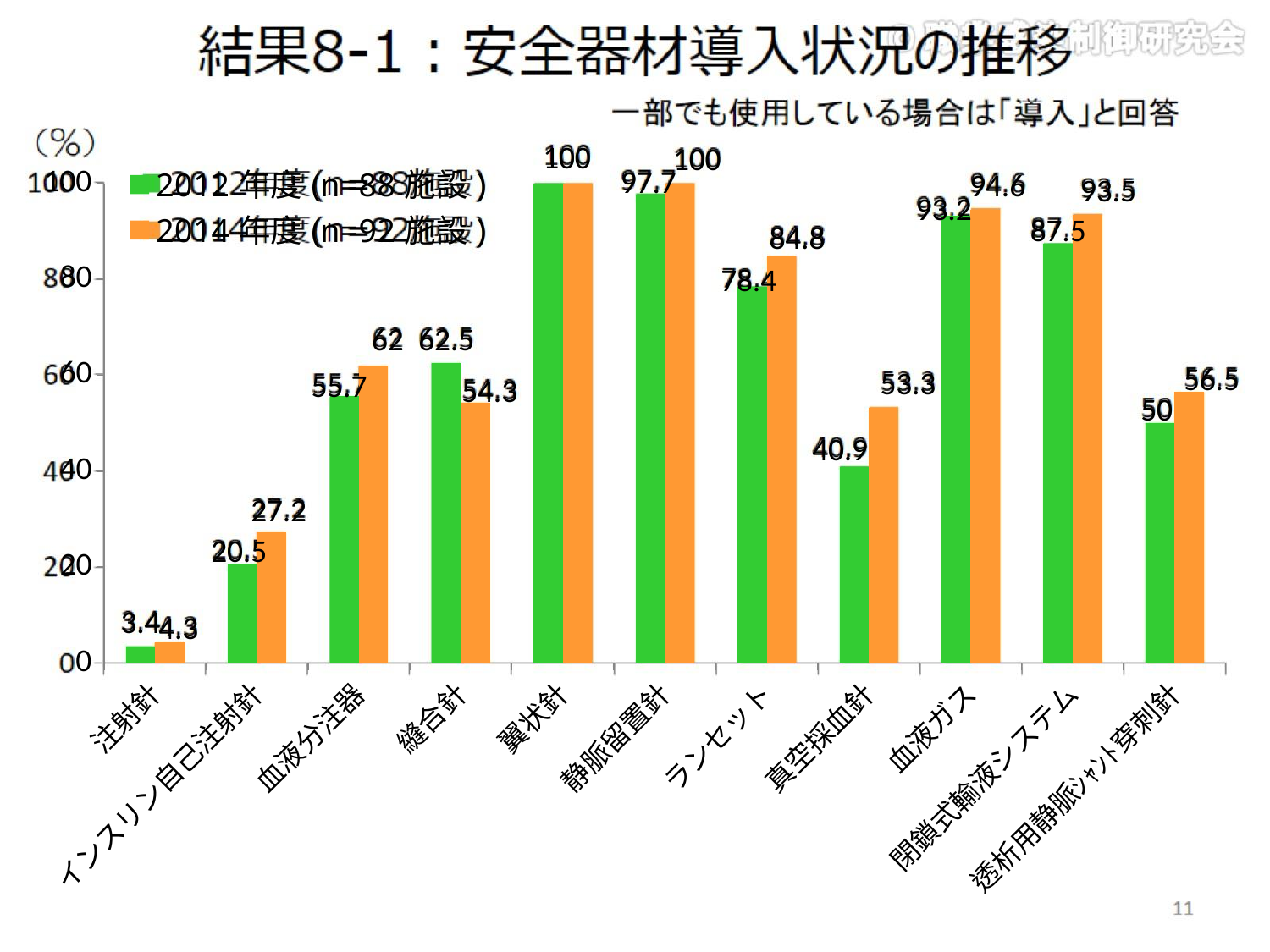
What type of chart is shown on the slide? bar chart For 縫合針, which is larger: the 2012年度 value or the 2014年度 value? 2012年度 How many series does the legend list? 2 What is the difference between the 2014年度 and 2012年度 values for 真空採血針? 12.4 What is the 2014年度 value for インスリン自己注射針? 27.2 What is the 2014年度 value for 真空採血針? 53.3 Which category has the highest 2012年度 value? 翼状針 Which category has the lowest 2012年度 value? 注射針 What colour represents the 2014年度 series? orange Is the 2012年度 value for 透析用静脈シャント穿刺針 greater or less than 60? less What is the 2012年度 value for ランセット? 78.4 How many categories are shown on the x axis? 11